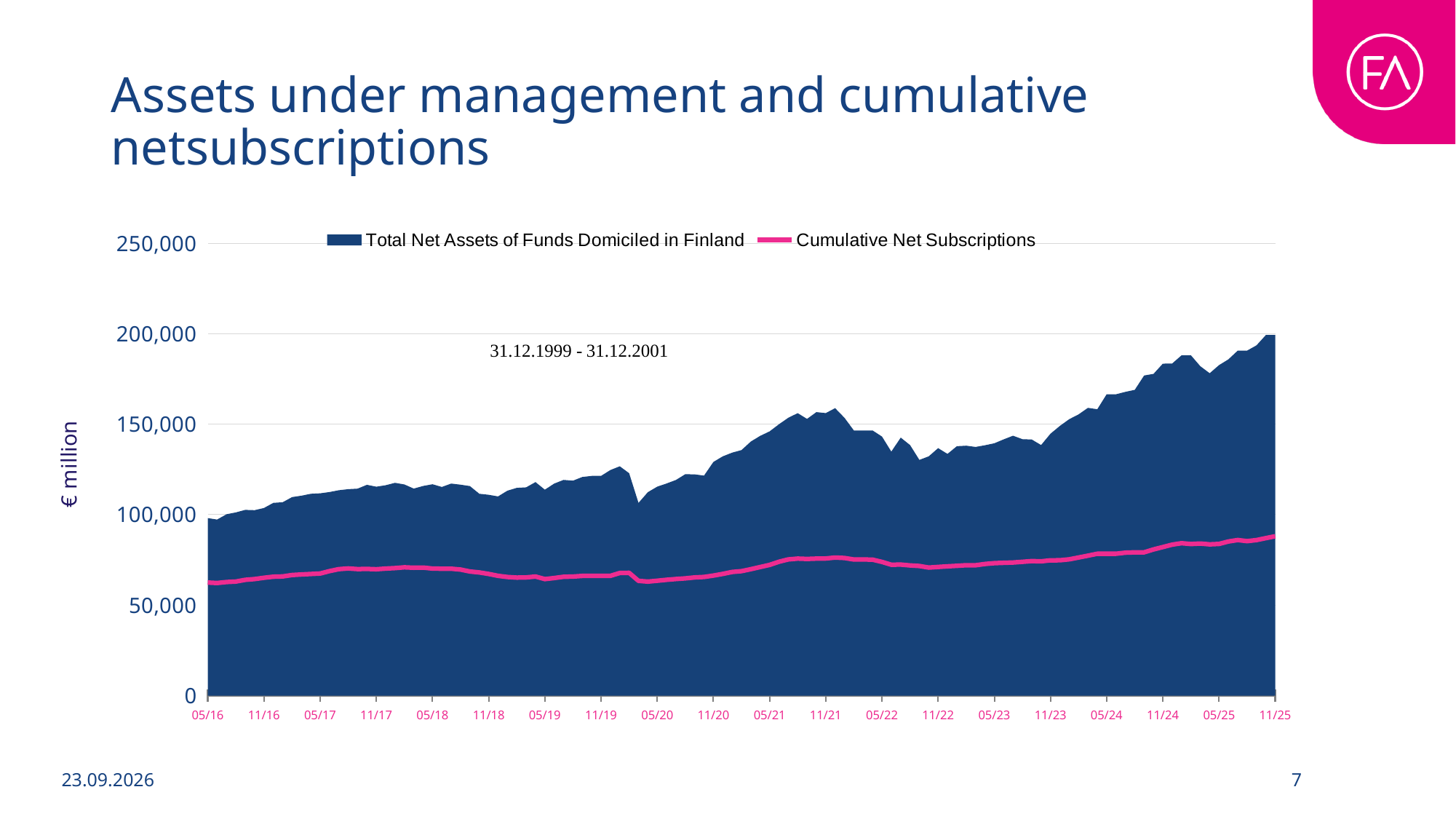
Is the value of Cumulative Net Subscriptions at 05/16 greater or less than 50,000? greater Does the Total Net Assets of Funds Domiciled in Finland series generally rise or fall from 05/16 to 11/25? rise At which x-axis date is Total Net Assets of Funds Domiciled in Finland at its lowest value? 05/16 How many series does the chart legend list? 2 Is the value of Cumulative Net Subscriptions at 11/25 greater or less than 100,000? less Is the value of Total Net Assets of Funds Domiciled in Finland at 11/24 greater or less than 150,000? greater Does the Cumulative Net Subscriptions line generally rise or fall from 05/16 to 11/25? rise At 11/21, which is larger: Total Net Assets of Funds Domiciled in Finland or Cumulative Net Subscriptions? Total Net Assets of Funds Domiciled in Finland What are the two series named in the chart legend? Total Net Assets of Funds Domiciled in Finland; Cumulative Net Subscriptions At which x-axis date does Total Net Assets of Funds Domiciled in Finland reach its highest value? 11/25 What unit is shown on the chart's vertical axis label? € million How many date labels are shown along the chart's x axis? 20